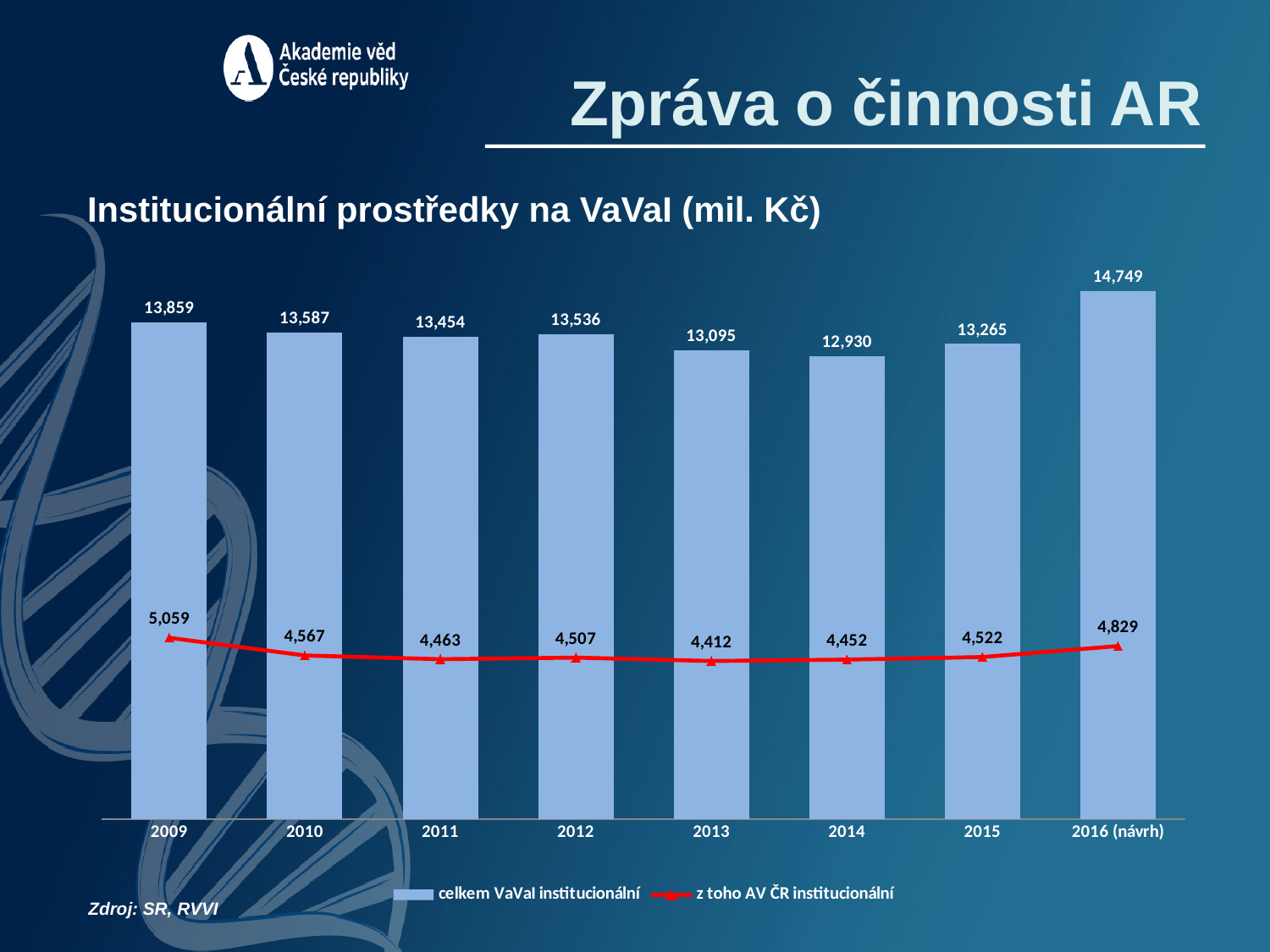
Which year has the highest value for 'celkem VaVaI institucionální'? 2016 (návrh) How many years are shown on the x axis? 8 What kind of chart is shown on the slide? A combined bar and line chart What is the value of 'z toho AV ČR institucionální' for 2013? 4,412 What is the value of 'celkem VaVaI institucionální' for 2009? 13,859 What is the difference between the 'celkem VaVaI institucionální' values for 2016 (návrh) and 2015? 1,484 What is the difference between the 'z toho AV ČR institucionální' values for 2009 and 2013? 647 What is the value of 'celkem VaVaI institucionální' for 2016 (návrh)? 14,749 How many series does the legend list? 2 Which year has the lowest value for 'z toho AV ČR institucionální'? 2013 Which year has the lowest value for 'celkem VaVaI institucionální'? 2014 Which is larger, the 'celkem VaVaI institucionální' value for 2010 or for 2012? 2010